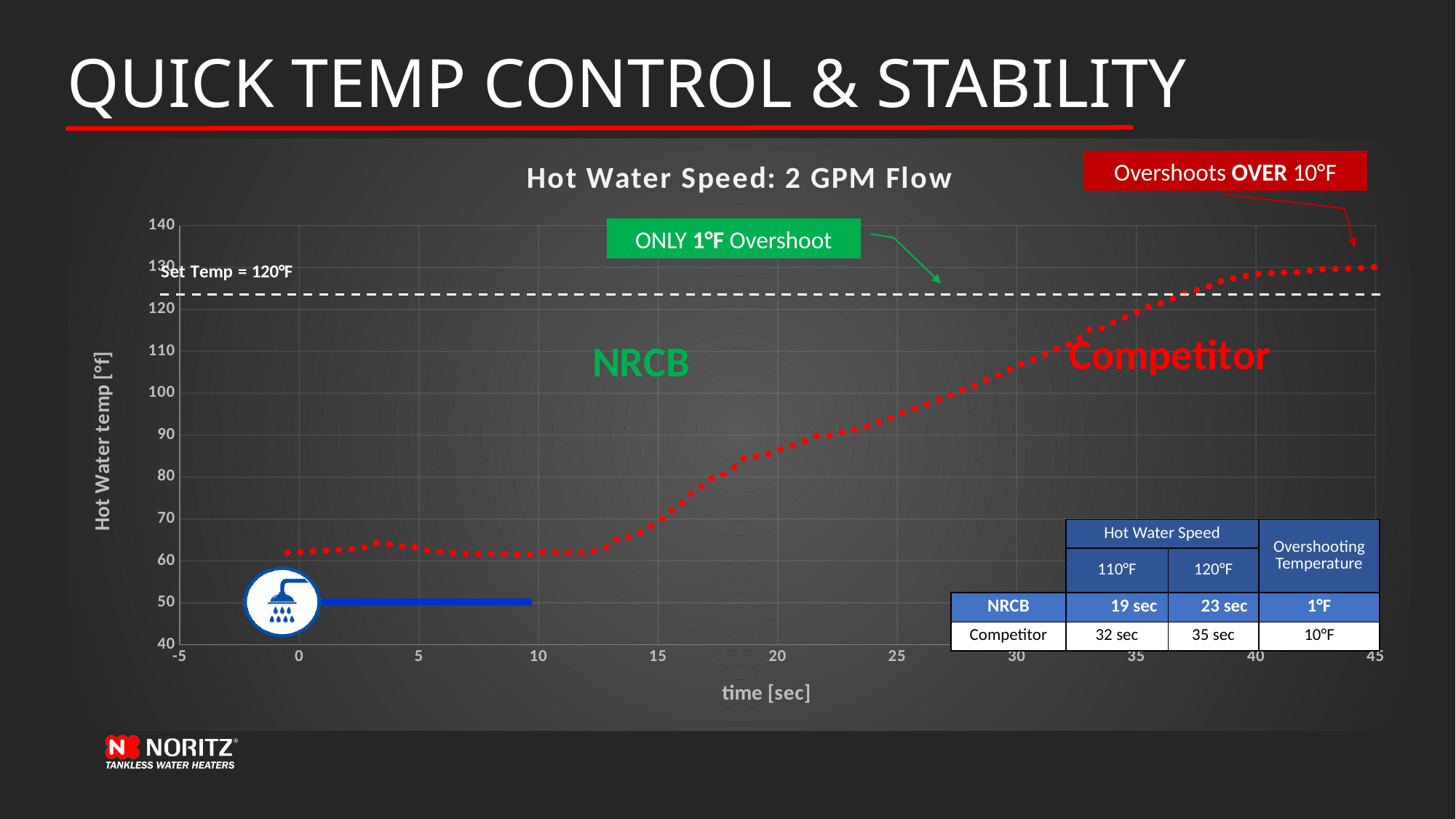
What is the set temperature marked by the dashed line on the chart? 120°F According to the table, how many seconds does the Competitor take to reach 110°F? 32 sec What is the title of the chart? Hot Water Speed: 2 GPM Flow Is the Competitor's hot water temperature at 25 sec greater or less than 100? less How many seconds faster does the NRCB reach 120°F than the Competitor, according to the table? 12 sec According to the table, how many seconds does the NRCB take to reach 120°F? 23 sec Is the Competitor's hot water temperature at 10 sec greater or less than 70? less What kind of chart is shown on the slide? line chart Which has the smaller overshooting temperature, NRCB or Competitor? NRCB Does the Competitor line rise or fall as time increases from 10 sec to 45 sec? rise Is the Competitor's hot water temperature at 45 sec greater or less than 120? greater What is the overshooting temperature of the Competitor in the table? 10°F